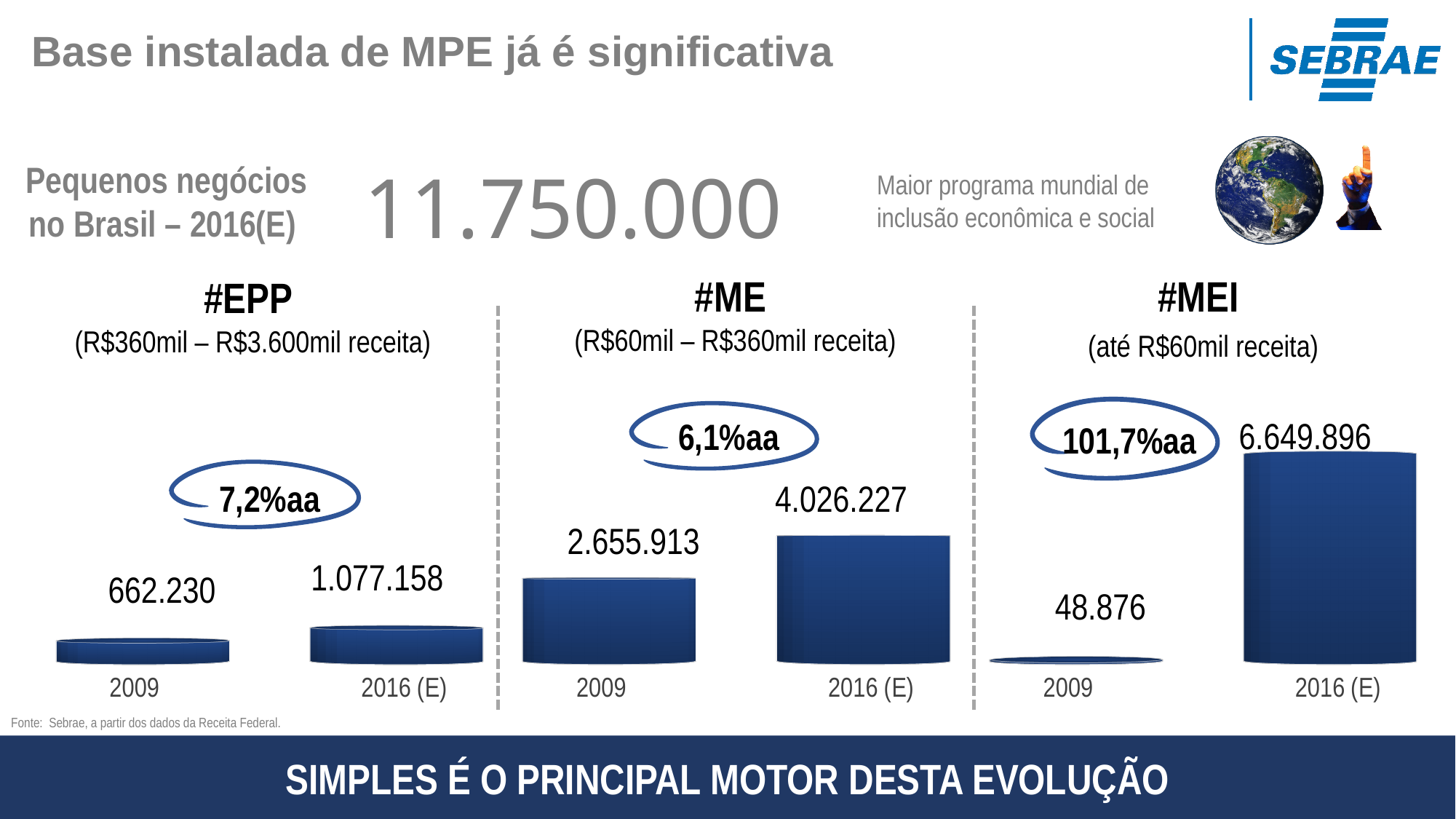
How many categories are plotted in the #MEI chart? 2 In the #ME chart, do the values rise or fall from 2009 to 2016 (E)? rise In the #MEI chart, what is the value for 2009? 48.876 In the #MEI chart, what is the difference between the 2016 (E) value and the 2009 value? 6.601.020 In the #EPP chart, what is the value for 2009? 662.230 In the #EPP chart, what is the value for 2016 (E)? 1.077.158 In the #ME chart, what is the value for 2009? 2.655.913 In the #MEI chart, what is the value for 2016 (E)? 6.649.896 In the #ME chart, what is the difference between the 2016 (E) value and the 2009 value? 1.370.314 In the #ME chart, what is the value for 2016 (E)? 4.026.227 What kind of chart is the #ME chart? bar chart In the #EPP chart, which category has the higher value, 2009 or 2016 (E)? 2016 (E)